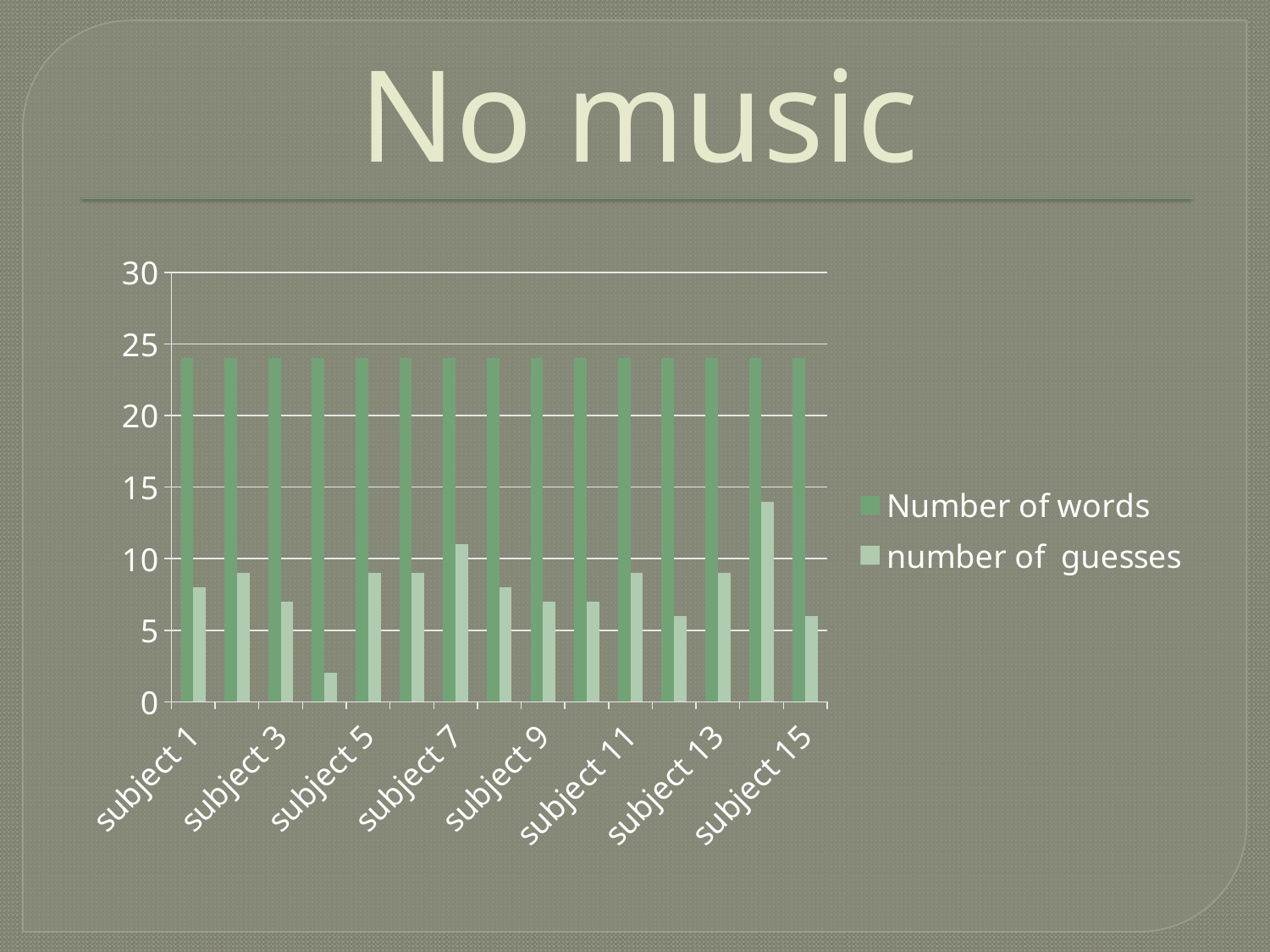
For subject 1, which series has the larger value, Number of words or number of guesses? Number of words Which is larger, the number of guesses for subject 7 or for subject 15? subject 7 How many series does the legend list? 2 How many subjects (categories) are plotted on the x axis? 15 What kind of chart is shown on the slide? bar chart Is the Number of words for subject 1 greater or less than 20? greater Is the number of guesses for subject 3 greater or less than 10? less Is the Number of words for subject 15 greater or less than 25? less What is the title of the slide containing the chart? No music What are the two series named in the legend? Number of words; number of guesses